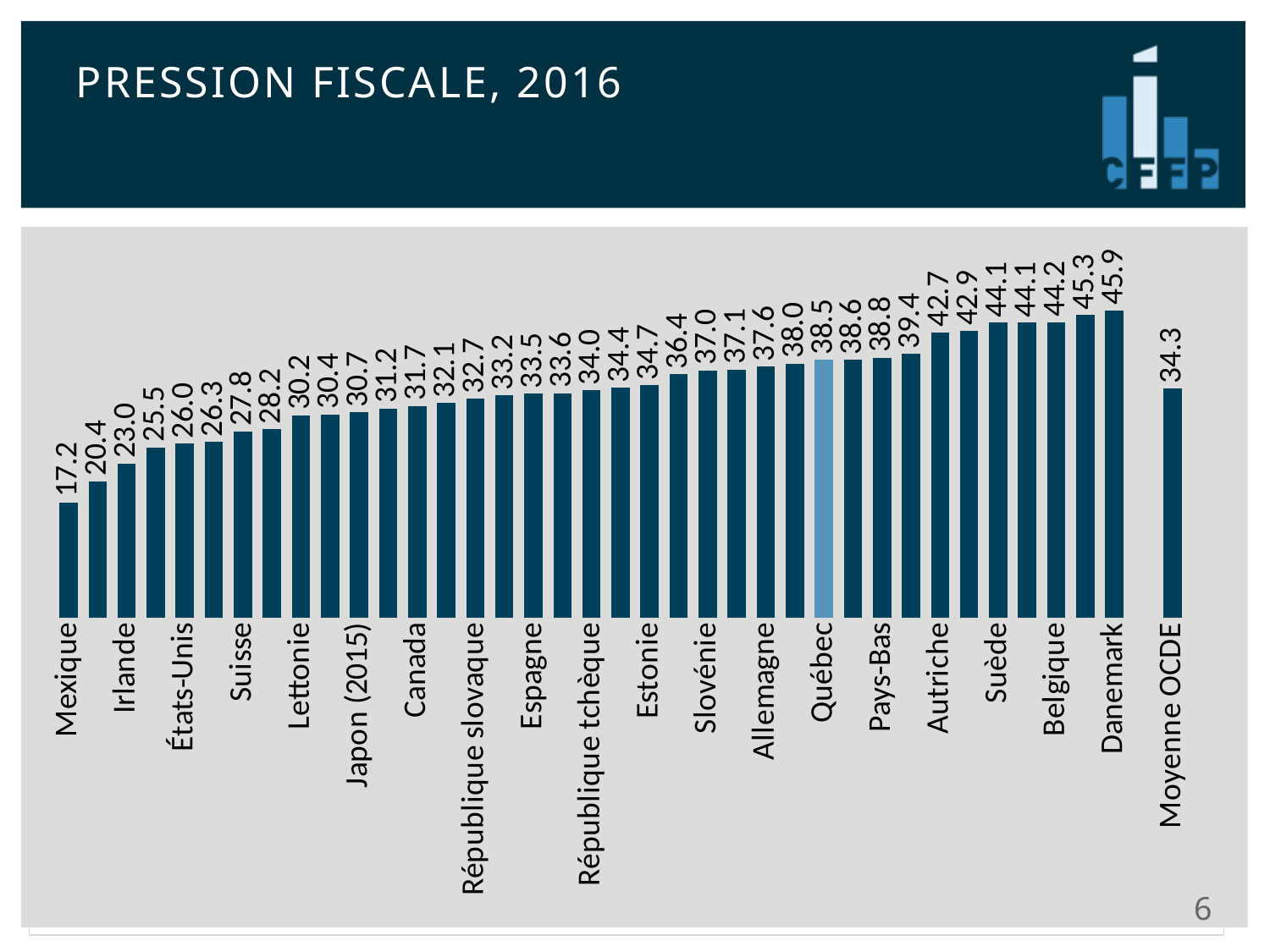
What is the value for Québec? 38.5 What is the difference between the value for Danemark and the value for Mexique? 28.7 Which country has the lowest value? Mexique Which is larger, the value for Canada or the value for Suisse? Canada What is the value for Moyenne OCDE? 34.3 Which category's bar is shown in a lighter blue colour than the others? Québec What is the value for Allemagne? 37.6 What is the difference between the value for Québec and the value for Moyenne OCDE? 4.2 What kind of chart is shown on the slide? bar chart What is the value for Mexique? 17.2 Which country has the highest value? Danemark What is the value for Danemark? 45.9